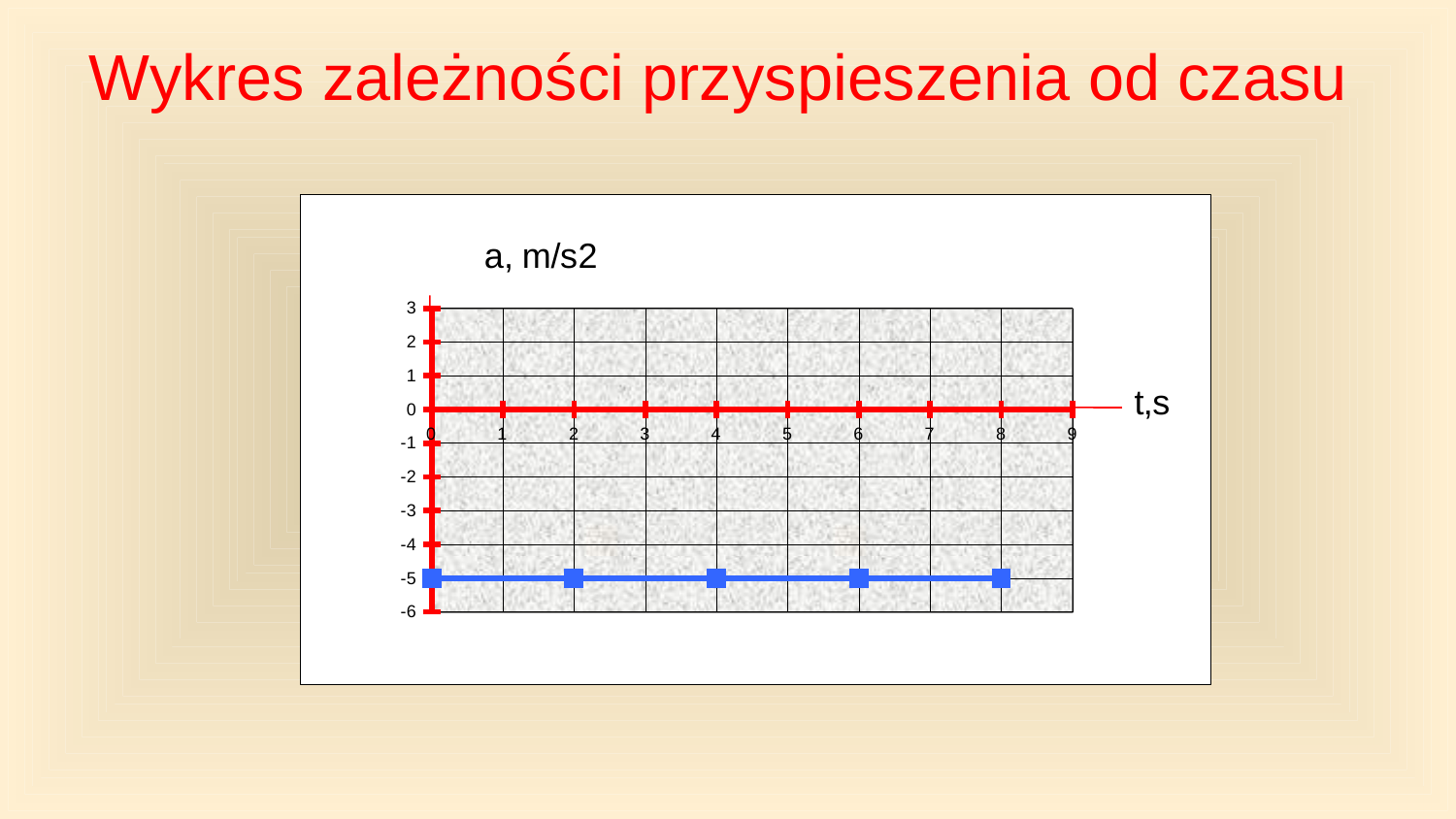
How many data points are plotted on the chart? 5 What is the value of a at t = 8 s? -5 What is the difference between the value of a at t = 2 s and at t = 6 s? 0 What is the value of a at t = 2 s? -5 Is the value of a at t = 6 s greater or less than -3? less Is the value of a at t = 4 s greater or less than 0? less Do the plotted values rise, fall, or stay constant as t increases? stay constant What is the title of the slide? Wykres zależności przyspieszenia od czasu What is the label of the vertical axis? a, m/s2 What is the value of a at t = 0 s? -5 What kind of chart is shown on the slide? line chart